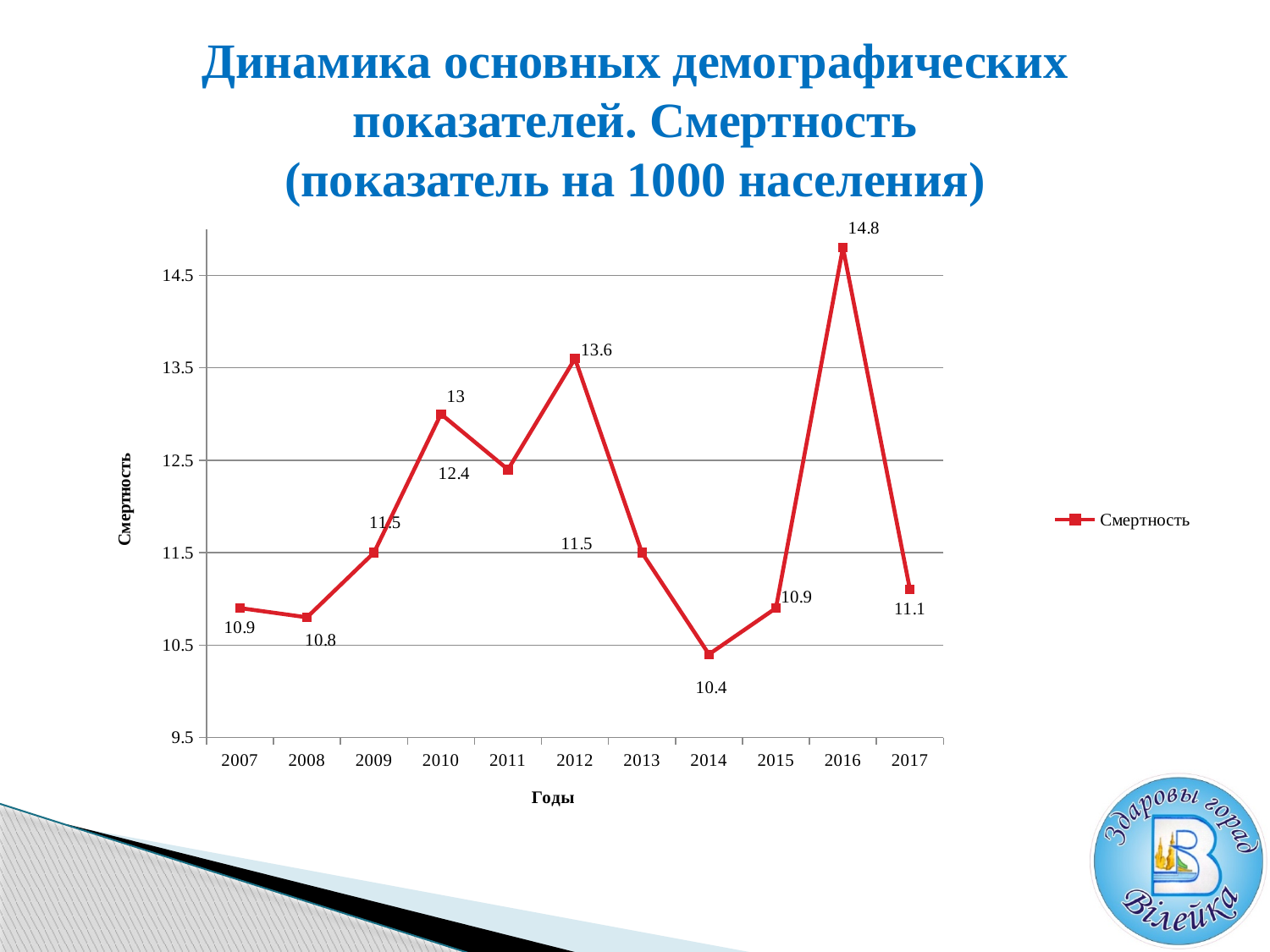
What is the difference between the mortality values for 2016 and 2017? 3.7 Is the mortality value for 2013 greater or less than 12.5? less What is the mortality value for 2014? 10.4 What is the label of the x axis? Годы What kind of chart is shown on the slide? line chart Which year has the lowest mortality value? 2014 What is the mortality value for 2016? 14.8 Which year has a larger mortality value, 2012 or 2011? 2012 What is the mortality value for 2010? 13 How many series does the legend list? 1 Which year has the highest mortality value? 2016 How many years are plotted on the x axis? 11